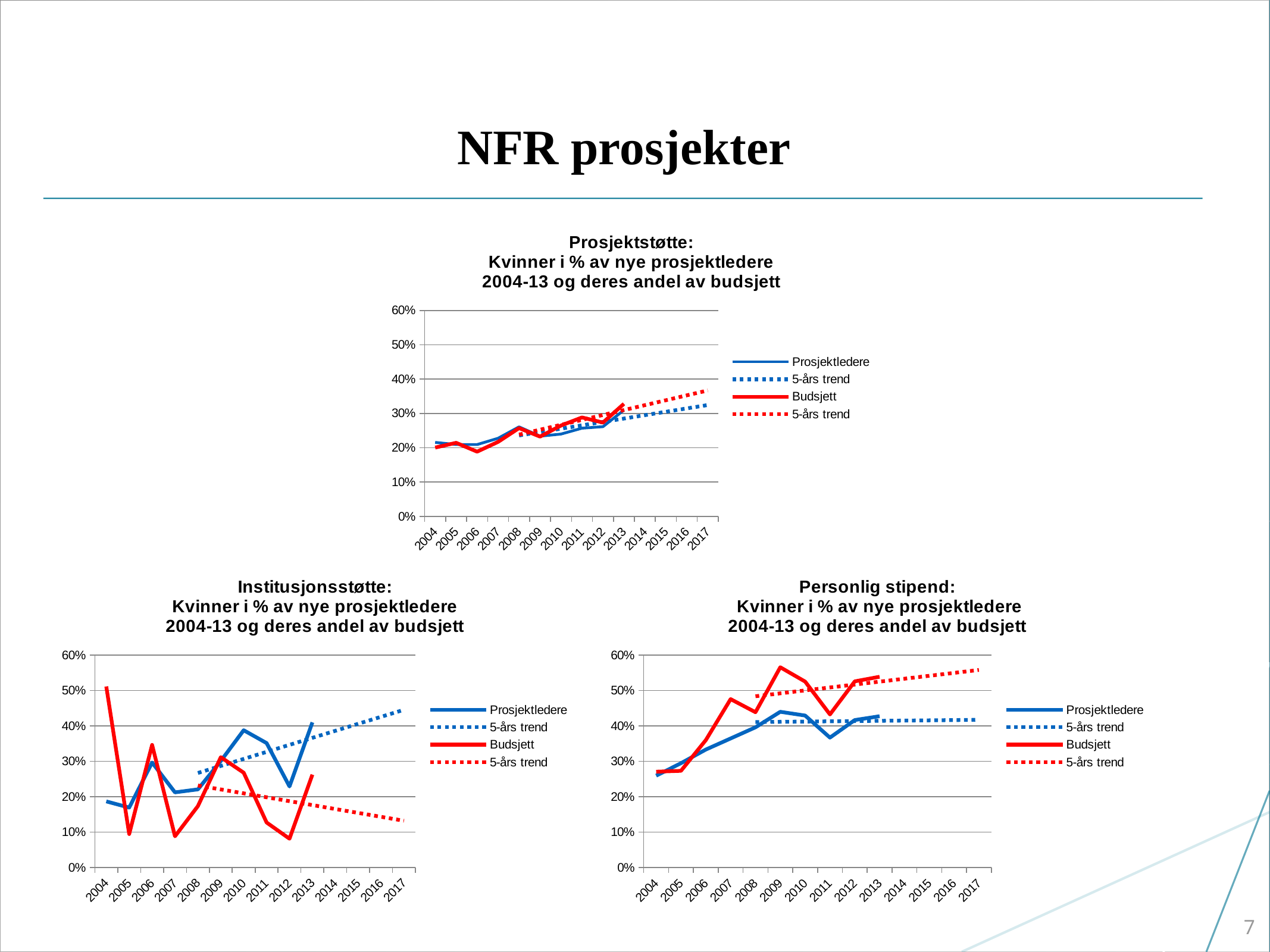
In the 'Personlig stipend' chart, which is larger in 2009: Budsjett or Prosjektledere? Budsjett How many entries does the legend of the 'Personlig stipend' chart list? 4 In the 'Personlig stipend' chart, is the Prosjektledere value for 2011 greater or less than 40%? less In the 'Prosjektstøtte' chart, does the Prosjektledere line generally rise or fall from 2004 to 2013? rise In the 'Institusjonsstøtte' chart, is the Budsjett value for 2012 greater or less than 10%? less How many years are labelled on the x axis of the 'Institusjonsstøtte' chart? 14 What colour is the Budsjett line in the 'Prosjektstøtte' chart? red What kind of chart is the 'Prosjektstøtte' chart at the top of the slide? line chart In the 'Institusjonsstøtte' chart, does the red dotted 5-års trend line rise or fall from 2008 to 2017? fall In the 'Prosjektstøtte' chart, is the Budsjett value for 2013 greater or less than 30%? greater In the 'Institusjonsstøtte' chart, which year has the highest Budsjett value? 2004 In the 'Personlig stipend' chart, which year has the highest Budsjett value? 2009